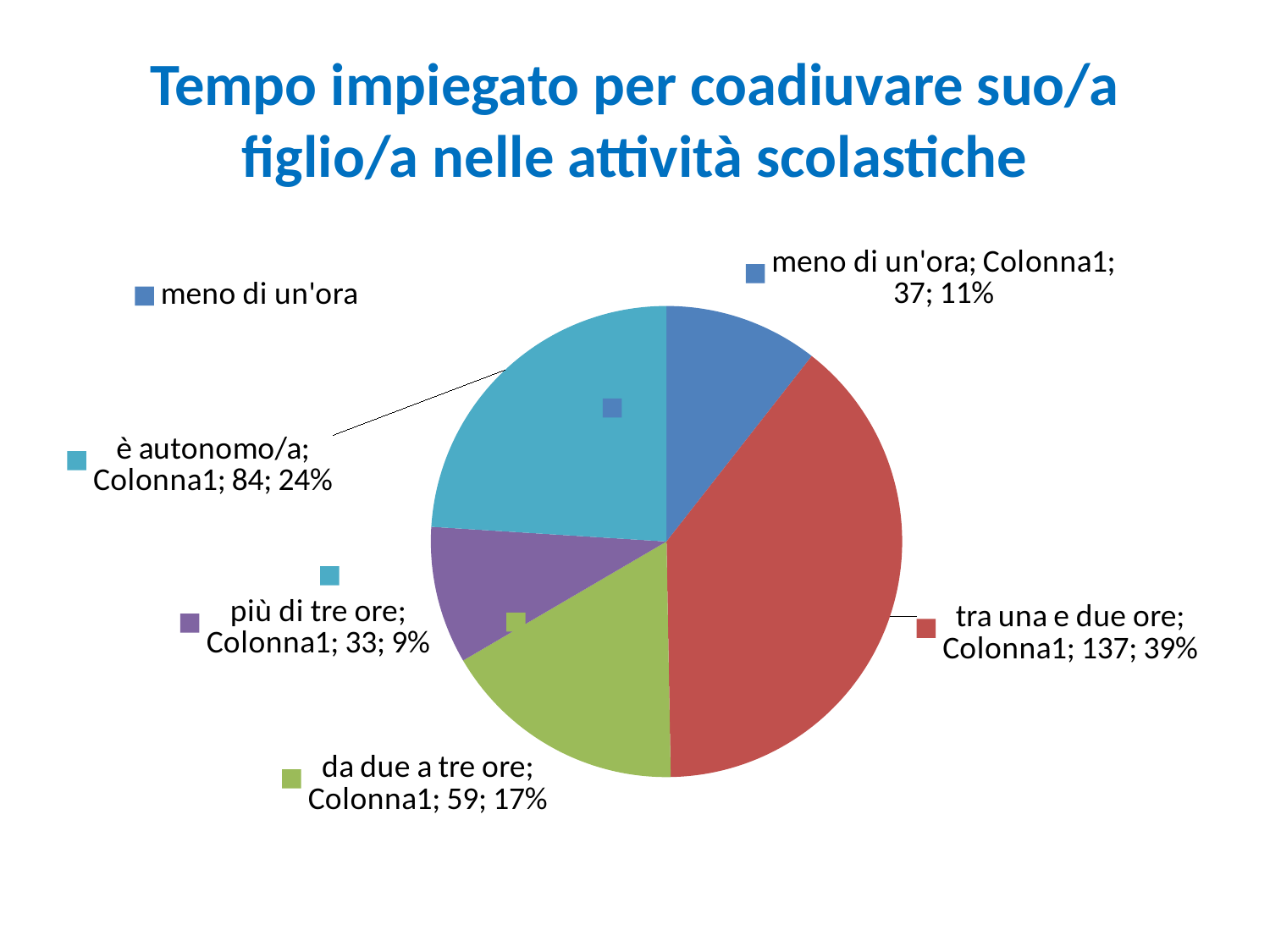
What is the title of the chart? Tempo impiegato per coadiuvare suo/a figlio/a nelle attività scolastiche What kind of chart is shown on the slide? pie chart What is the value for "più di tre ore"? 33 What is the value for "tra una e due ore"? 137 What percentage share does "da due a tre ore" have? 17% How many slices does the pie chart have? 5 What is the difference between the values for "tra una e due ore" and "è autonomo/a"? 53 Which category has the smallest slice? più di tre ore What percentage share does "meno di un'ora" have? 11% Which is larger, the value for "da due a tre ore" or the value for "meno di un'ora"? da due a tre ore Which category has the largest slice? tra una e due ore What is the value for "è autonomo/a"? 84